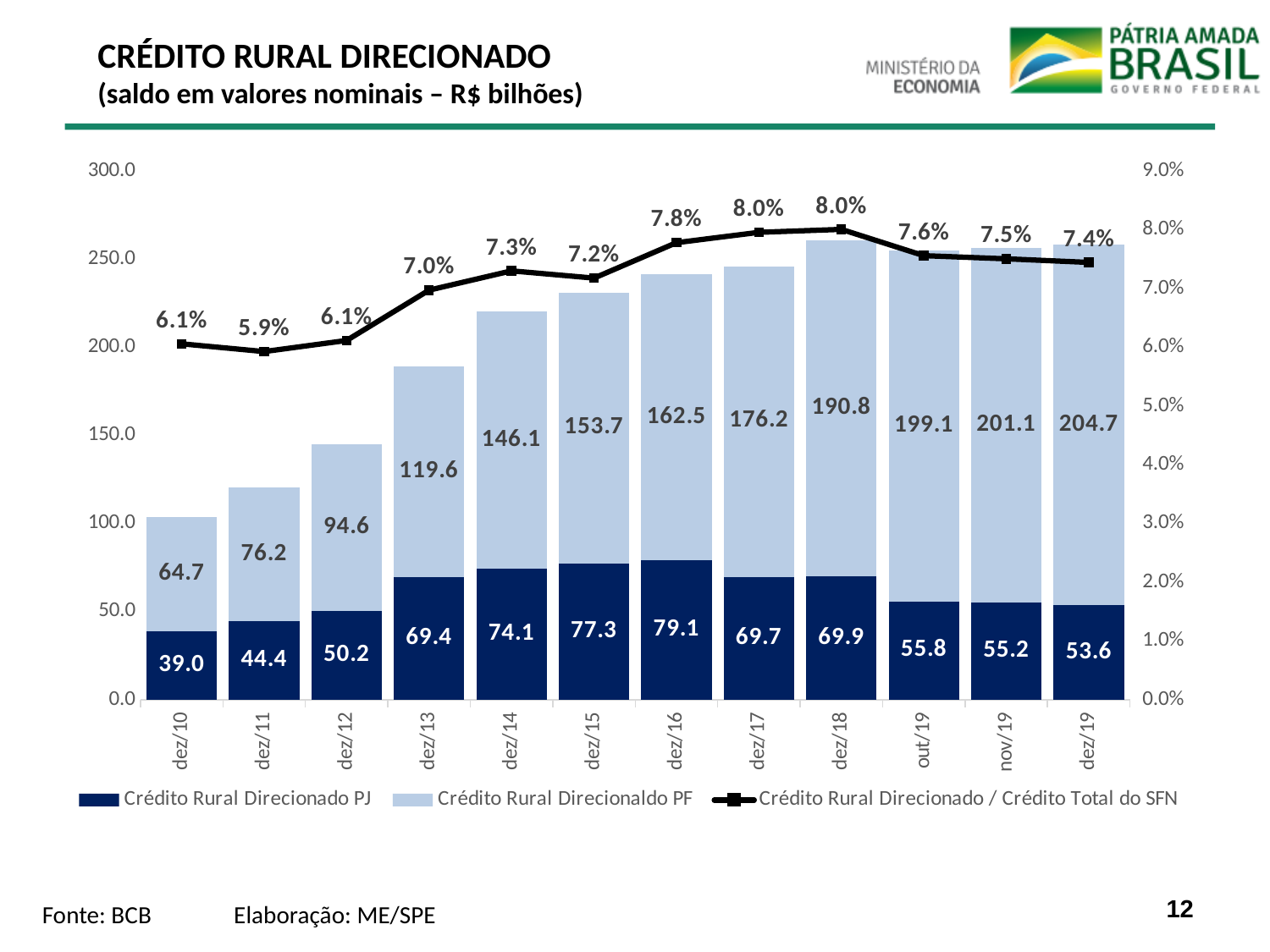
What kind of chart is shown on the slide? Stacked bar chart with a line What is the total of the stacked bar for dez/19? 258.3 How many series does the legend list? 3 What is the value of Crédito Rural Direcionaldo PF for dez/18? 190.8 Does Crédito Rural Direcionaldo PF rise or fall from dez/10 to dez/19? Rise How many periods are shown on the x axis? 12 Which is larger: Crédito Rural Direcionado PJ in dez/15 or in dez/17? dez/15 What is the value of Crédito Rural Direcionado PJ for dez/13? 69.4 What is the value of Crédito Rural Direcionado / Crédito Total do SFN for dez/14? 7.3% In which period is Crédito Rural Direcionado PJ highest? dez/16 What is the difference between Crédito Rural Direcionaldo PF in dez/19 and in dez/10? 140.0 In which period is Crédito Rural Direcionado / Crédito Total do SFN lowest? dez/11